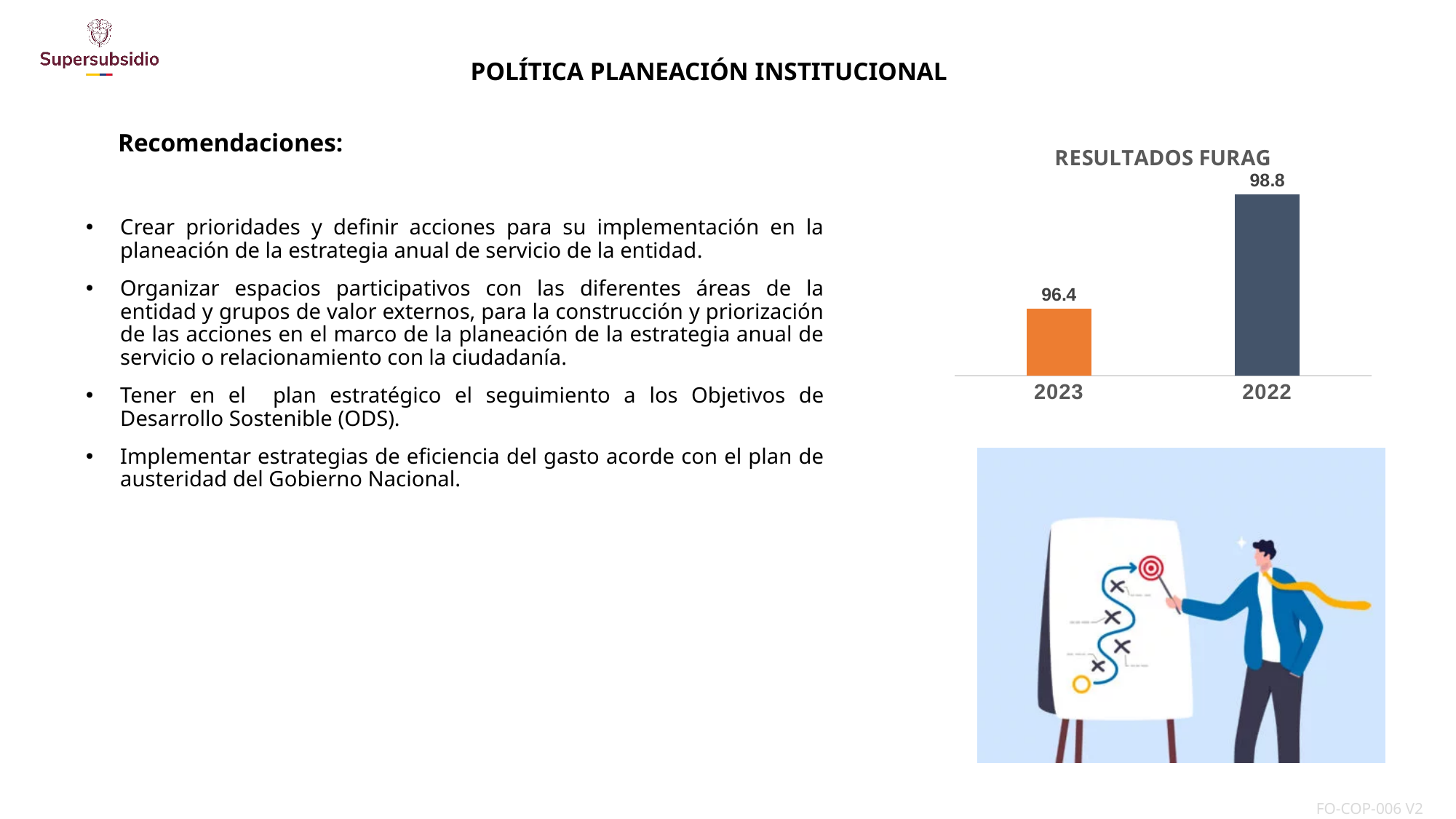
What is the value for 2022 in the RESULTADOS FURAG chart? 98.8 What type of chart is RESULTADOS FURAG? bar chart What colour is the bar for 2023 in the RESULTADOS FURAG chart? orange In the RESULTADOS FURAG chart, is the value for 2023 larger or smaller than the value for 2022? smaller How many bars are shown in the RESULTADOS FURAG chart? 2 What is the difference between the 2022 and 2023 values in the RESULTADOS FURAG chart? 2.4 Which year has the lowest value in the RESULTADOS FURAG chart? 2023 What is the value for 2023 in the RESULTADOS FURAG chart? 96.4 Do the values in the RESULTADOS FURAG chart rise or fall from left to right along the x axis? rise Which year has the highest value in the RESULTADOS FURAG chart? 2022 What is the title of the chart on the slide? RESULTADOS FURAG